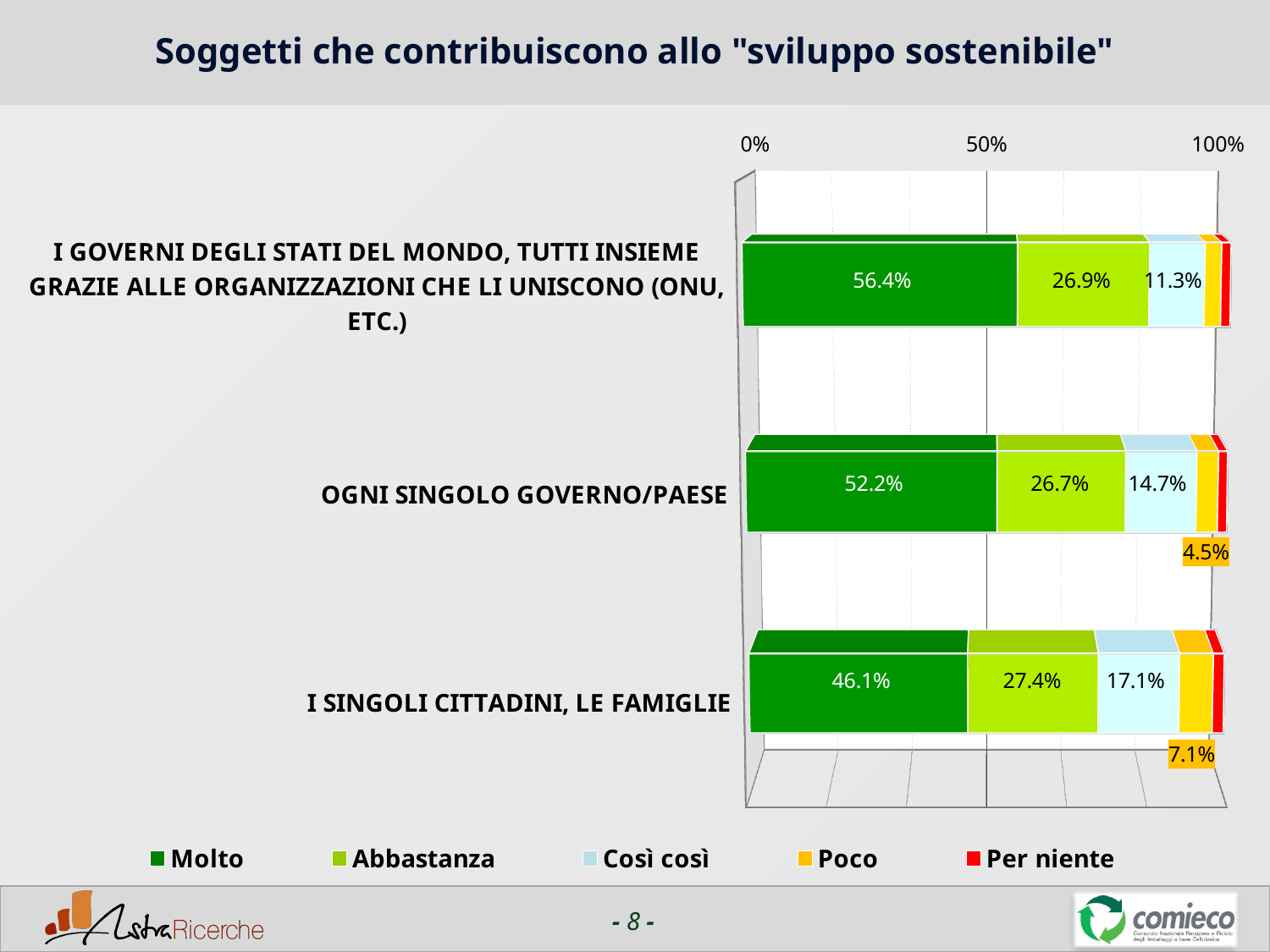
What is the "Così così" value for "I SINGOLI CITTADINI, LE FAMIGLIE"? 17.1% How many categories are shown on the chart? 3 What is the difference between the "Molto" values for "I GOVERNI DEGLI STATI DEL MONDO..." and "I SINGOLI CITTADINI, LE FAMIGLIE"? 10.3% How many series does the legend list? 5 Which is larger: the "Così così" value for "OGNI SINGOLO GOVERNO/PAESE" or for "I SINGOLI CITTADINI, LE FAMIGLIE"? I SINGOLI CITTADINI, LE FAMIGLIE What is the "Molto" value for "I GOVERNI DEGLI STATI DEL MONDO, TUTTI INSIEME GRAZIE ALLE ORGANIZZAZIONI CHE LI UNISCONO (ONU, ETC.)"? 56.4% What kind of chart is shown on the slide? Stacked bar chart Is the "Molto" value for "I SINGOLI CITTADINI, LE FAMIGLIE" greater or less than 50%? less What is the "Abbastanza" value for "OGNI SINGOLO GOVERNO/PAESE"? 26.7% What is the "Poco" value for "I SINGOLI CITTADINI, LE FAMIGLIE"? 7.1% Which category has the lowest "Molto" value? I SINGOLI CITTADINI, LE FAMIGLIE Which category has the highest "Molto" value? I GOVERNI DEGLI STATI DEL MONDO, TUTTI INSIEME GRAZIE ALLE ORGANIZZAZIONI CHE LI UNISCONO (ONU, ETC.)